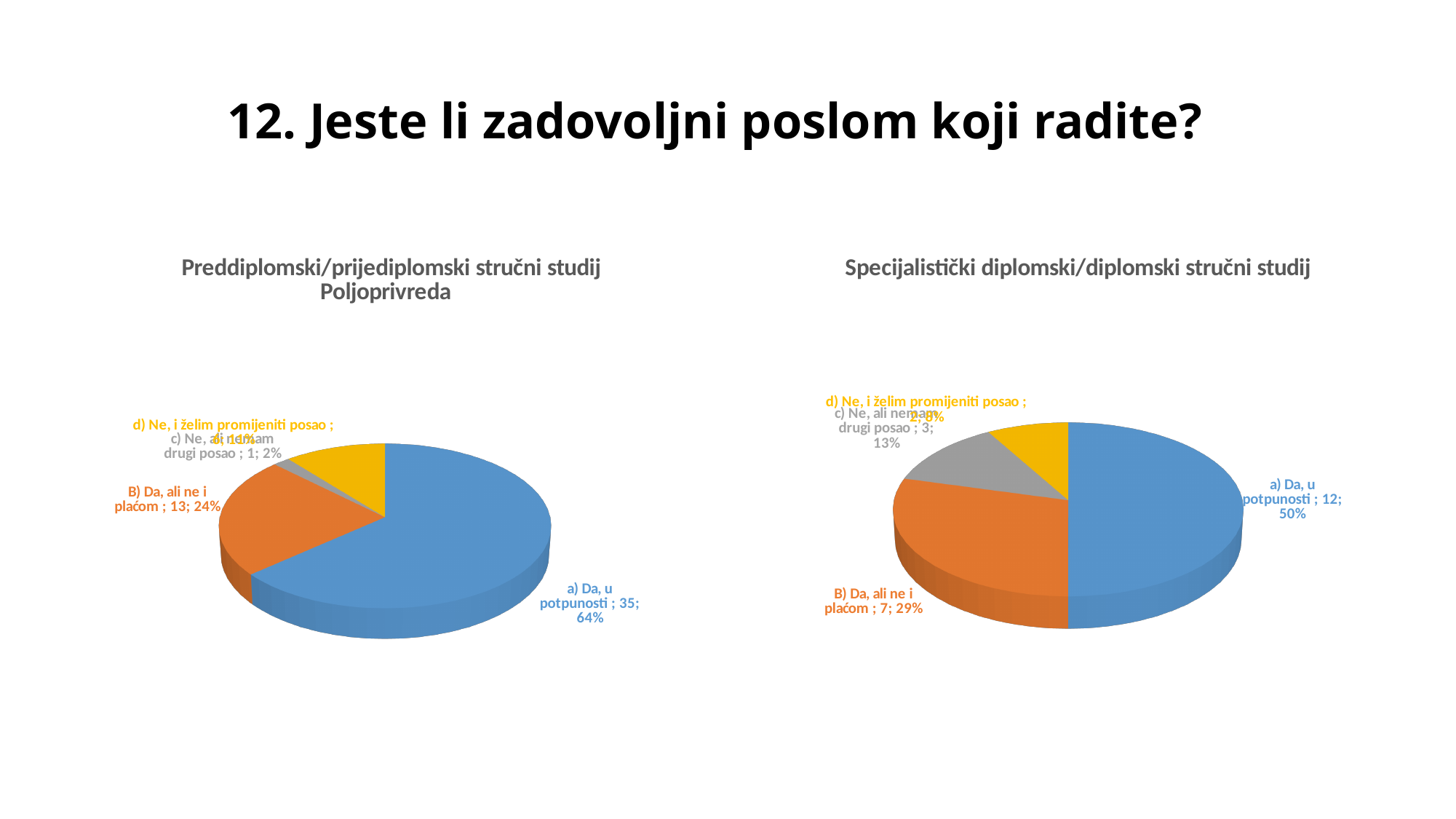
In the right chart (Specijalistički diplomski/diplomski stručni studij), how many answer categories are shown? 4 In the left chart (Preddiplomski/prijediplomski stručni studij Poljoprivreda), how many respondents answered 'a) Da, u potpunosti'? 35 In the right chart (Specijalistički diplomski/diplomski stručni studij), which answer has the largest slice? a) Da, u potpunosti Which chart has more respondents answering 'a) Da, u potpunosti', the left chart or the right chart? The left chart In the right chart (Specijalistički diplomski/diplomski stručni studij), how many respondents answered 'B) Da, ali ne i plaćom'? 7 In the left chart (Preddiplomski/prijediplomski stručni studij Poljoprivreda), what is the difference in respondents between 'a) Da, u potpunosti' and 'B) Da, ali ne i plaćom'? 22 In the right chart (Specijalistički diplomski/diplomski stručni studij), how many respondents answered 'c) Ne, ali nemam drugi posao'? 3 In the left chart (Preddiplomski/prijediplomski stručni studij Poljoprivreda), what percentage share does 'a) Da, u potpunosti' have? 64% In the left chart (Preddiplomski/prijediplomski stručni studij Poljoprivreda), which answer has the smallest slice? c) Ne, ali nemam drugi posao In the left chart (Preddiplomski/prijediplomski stručni studij Poljoprivreda), how many respondents answered 'B) Da, ali ne i plaćom'? 13 What kind of chart is used on the left, titled 'Preddiplomski/prijediplomski stručni studij Poljoprivreda'? Pie chart In the right chart (Specijalistički diplomski/diplomski stručni studij), what percentage share does 'a) Da, u potpunosti' have? 50%